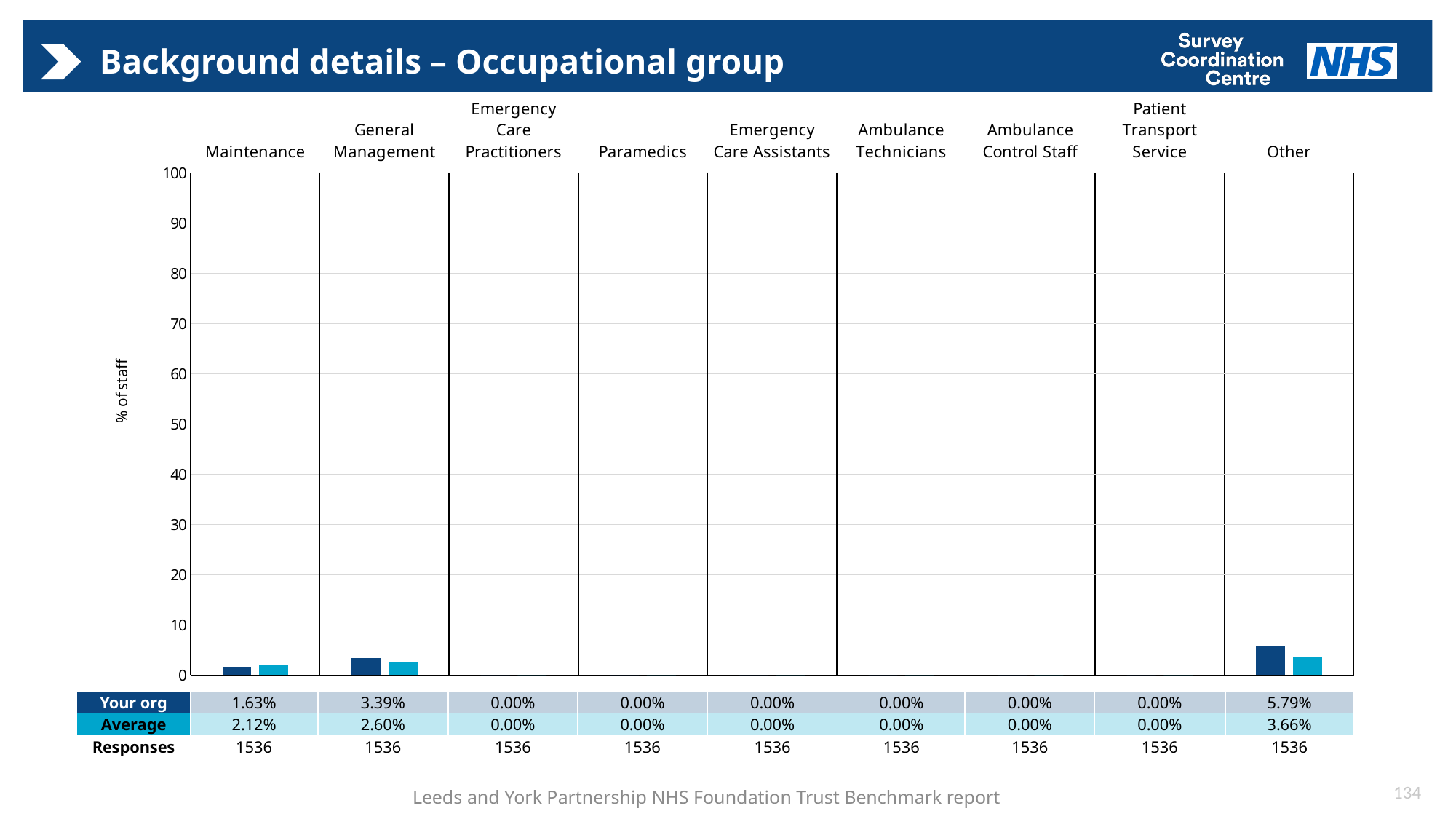
For General Management, which is larger: the 'Your org' value or the Average value? Your org What is the Average value for General Management? 2.60% What is the difference between the 'Your org' and Average values for Maintenance? 0.49% What is the 'Your org' value for Maintenance? 1.63% What is the difference between the 'Your org' and Average values for Other? 2.13% Which occupational group has the highest 'Your org' value? Other What type of chart is shown on the slide? Bar chart For Maintenance, which is larger: the 'Your org' value or the Average value? Average How many occupational groups are shown on the chart? 9 What is the Average value for Other? 3.66% What is the 'Your org' value for Other? 5.79% How many series are shown in the chart (Your org and Average)? 2